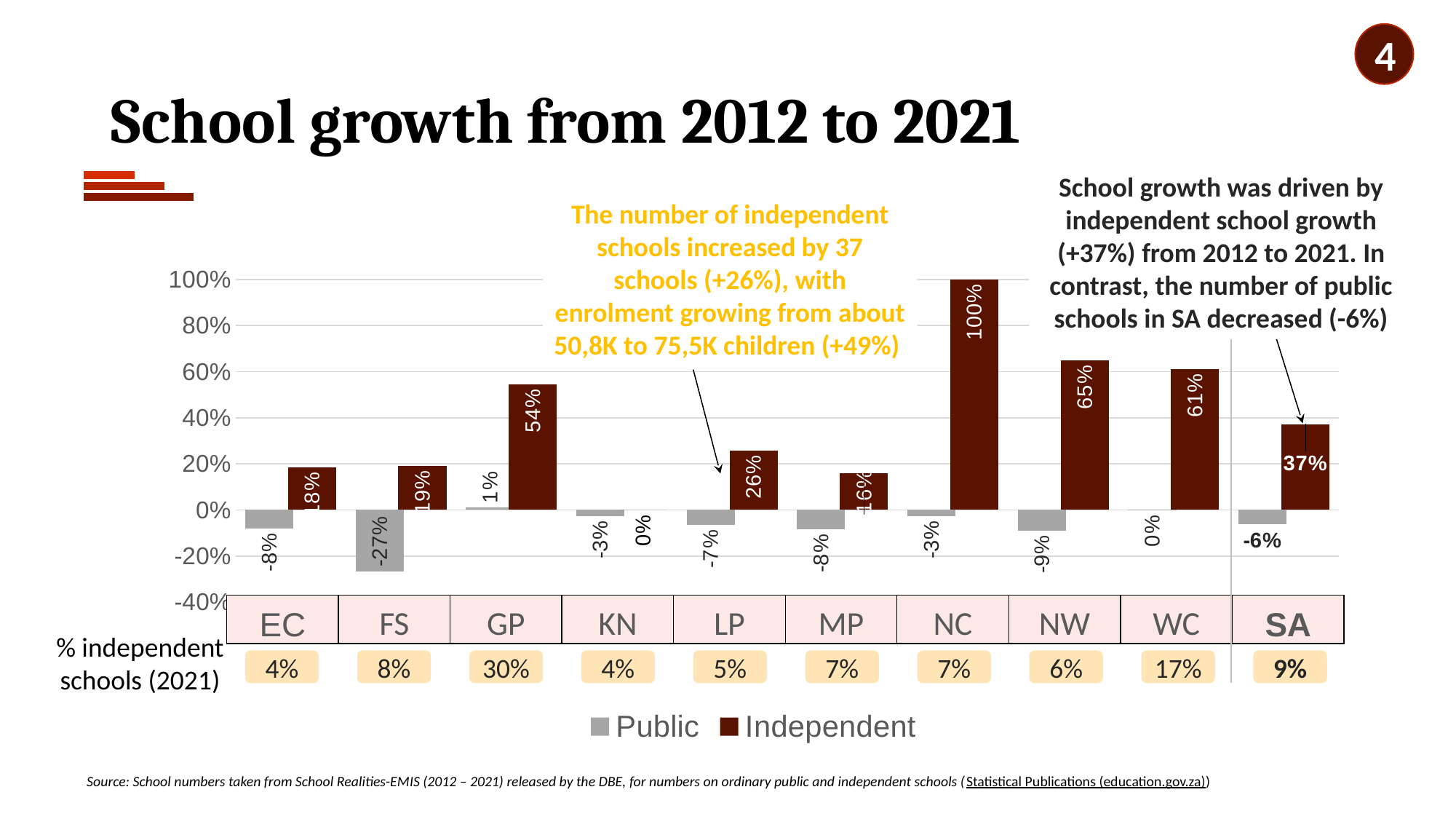
How many series does the legend list? 2 Which category has the highest Independent school growth? NC What is the Public school growth value for WC? 0% What kind of chart is shown on the slide? Bar chart How many categories are shown on the x axis of the chart? 10 Which has a larger Independent growth value, GP or NW? NW What is the difference between the Independent growth for NW and for WC? 4 percentage points What is the Independent school growth value for LP? 26% Which category has the lowest Public school growth? FS What is the Independent school growth value for NC? 100% What is the Public school growth value for FS? -27% What is the Independent school growth value for SA? 37%